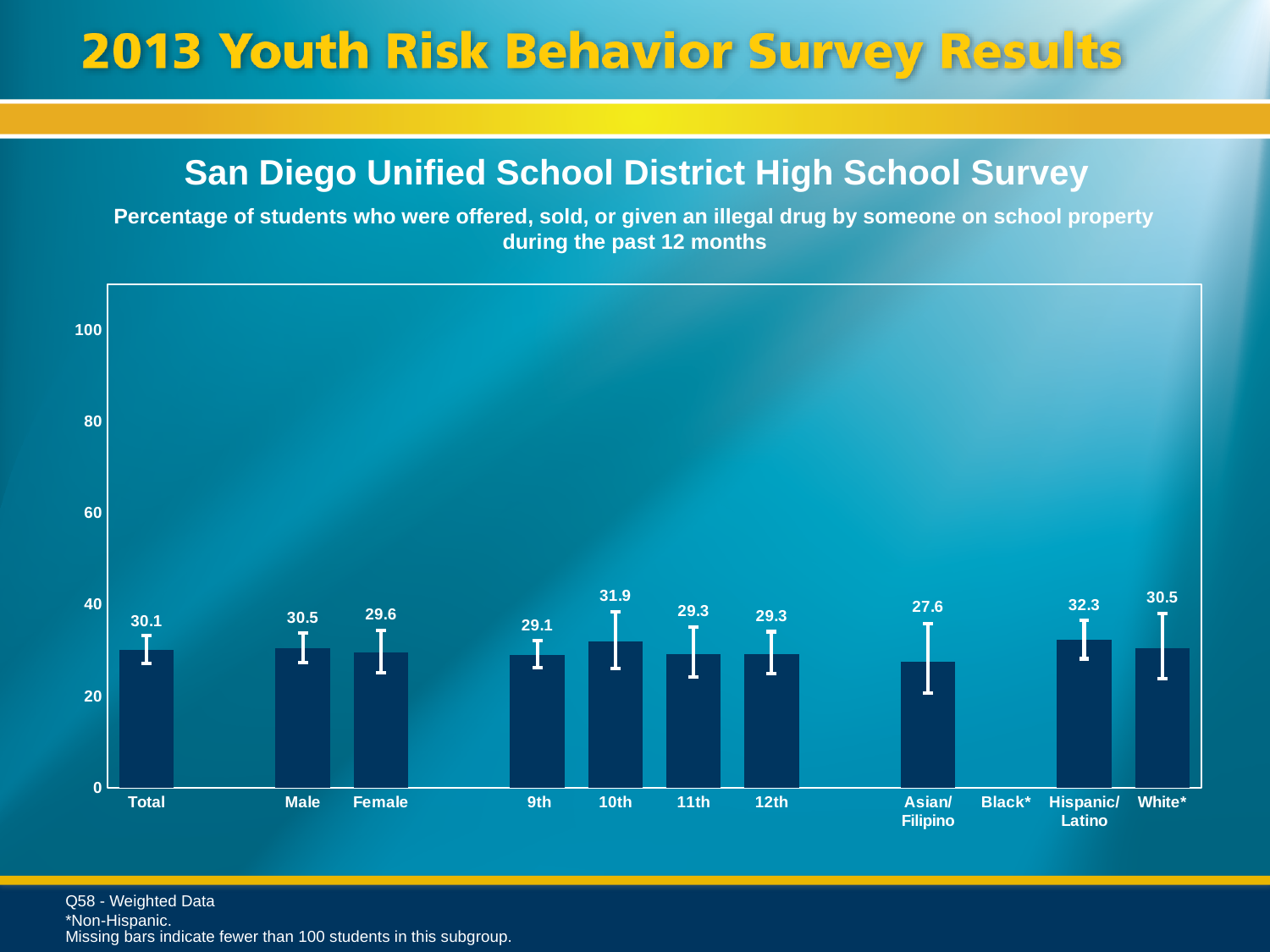
Is the value for White* greater or less than 40? less Which category has the highest value? Hispanic/Latino What is the value for Total? 30.1 What kind of chart is shown? bar chart What is the value for Asian/Filipino? 27.6 What is the difference between the Male and Female values? 0.9 How many categories are labeled on the x axis? 11 What is the value for Male? 30.5 Which is larger, the value for 9th grade or 10th grade? 10th Which category with a bar has the lowest value? Asian/Filipino What is the value for 10th grade? 31.9 Which category has no bar shown? Black*